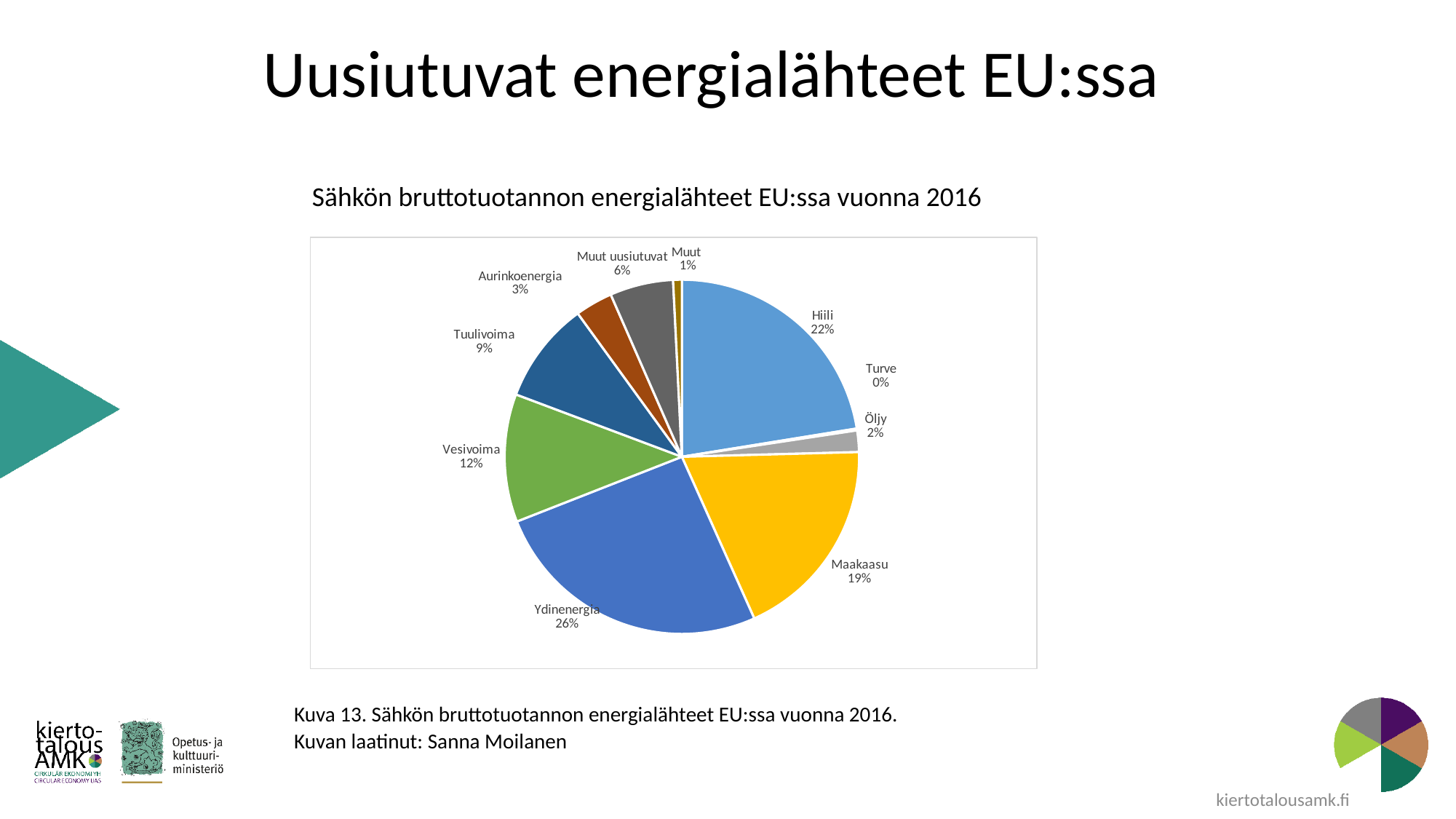
What is the title of the chart? Sähkön bruttotuotannon energialähteet EU:ssa vuonna 2016 What type of chart is shown on the slide? pie chart Which category has the smallest share shown in the pie? Turve Which category has the largest slice of the pie? Ydinenergia What is the value shown for Muut uusiutuvat? 6% What share of the pie does Ydinenergia have? 26% What is the difference in percentage points between Ydinenergia and Vesivoima? 14 Which is larger, the share for Hiili or the share for Maakaasu? Hiili How many categories are shown in the pie chart? 10 What is the value shown for Hiili? 22% What is the value shown for Maakaasu? 19% What is the value shown for Tuulivoima? 9%